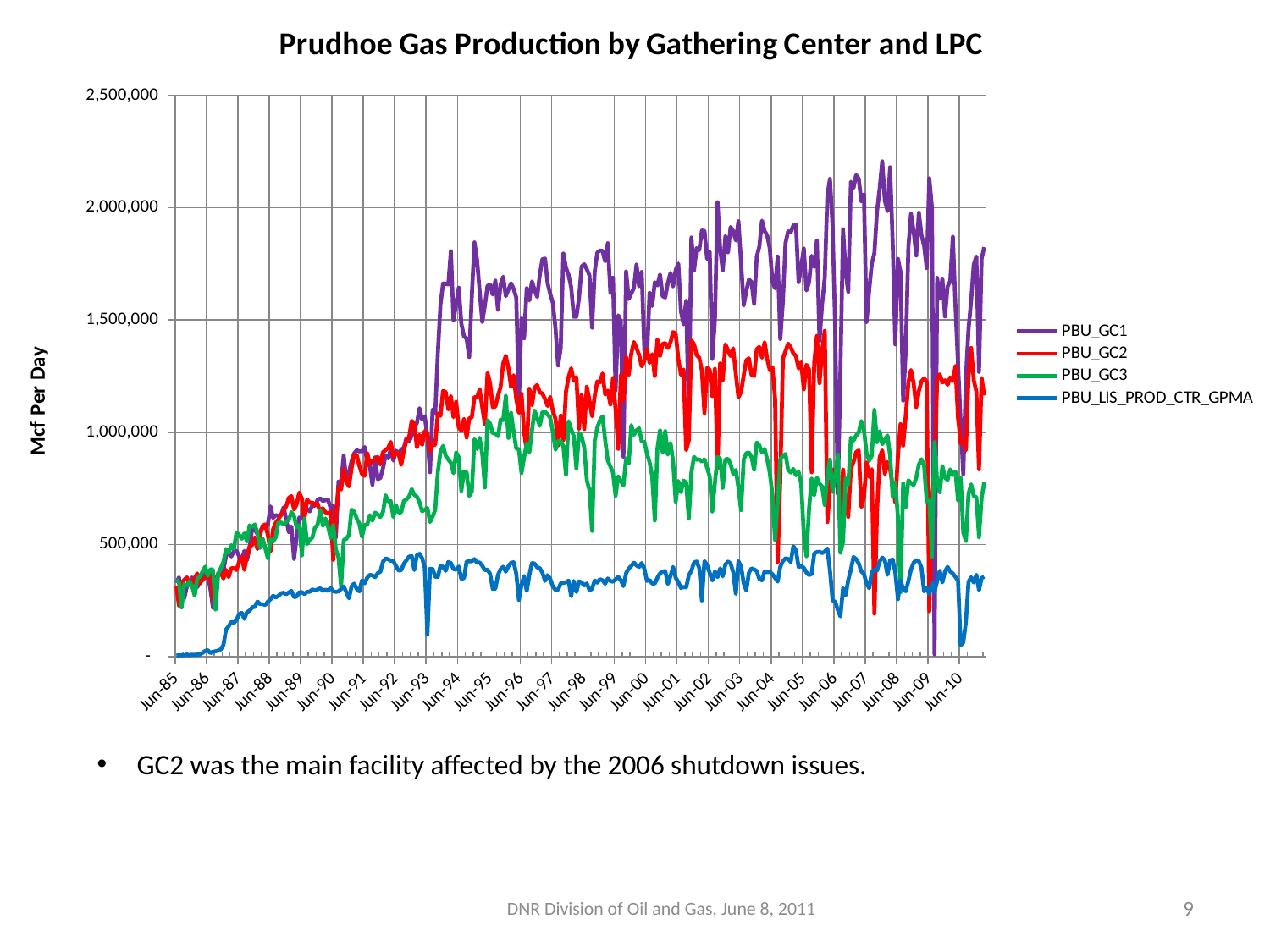
What is the title of the chart? Prudhoe Gas Production by Gathering Center and LPC How many date labels are shown along the x axis? 26 Is the peak value of PBU_GC1 greater or less than 2,000,000? greater Which series has the lowest value at Jun-10? PBU_LIS_PROD_CTR_GPMA How many series does the legend list? 4 At Jun-10, which is larger, PBU_GC2 or PBU_GC3? PBU_GC2 Is the value for PBU_LIS_PROD_CTR_GPMA at Jun-90 greater or less than 500,000? less Does PBU_GC1 generally rise or fall between Jun-85 and Jun-93? rise Which series reaches the highest values on the chart? PBU_GC1 What is the label on the vertical axis? Mcf Per Day What kind of chart is shown on the slide? line chart